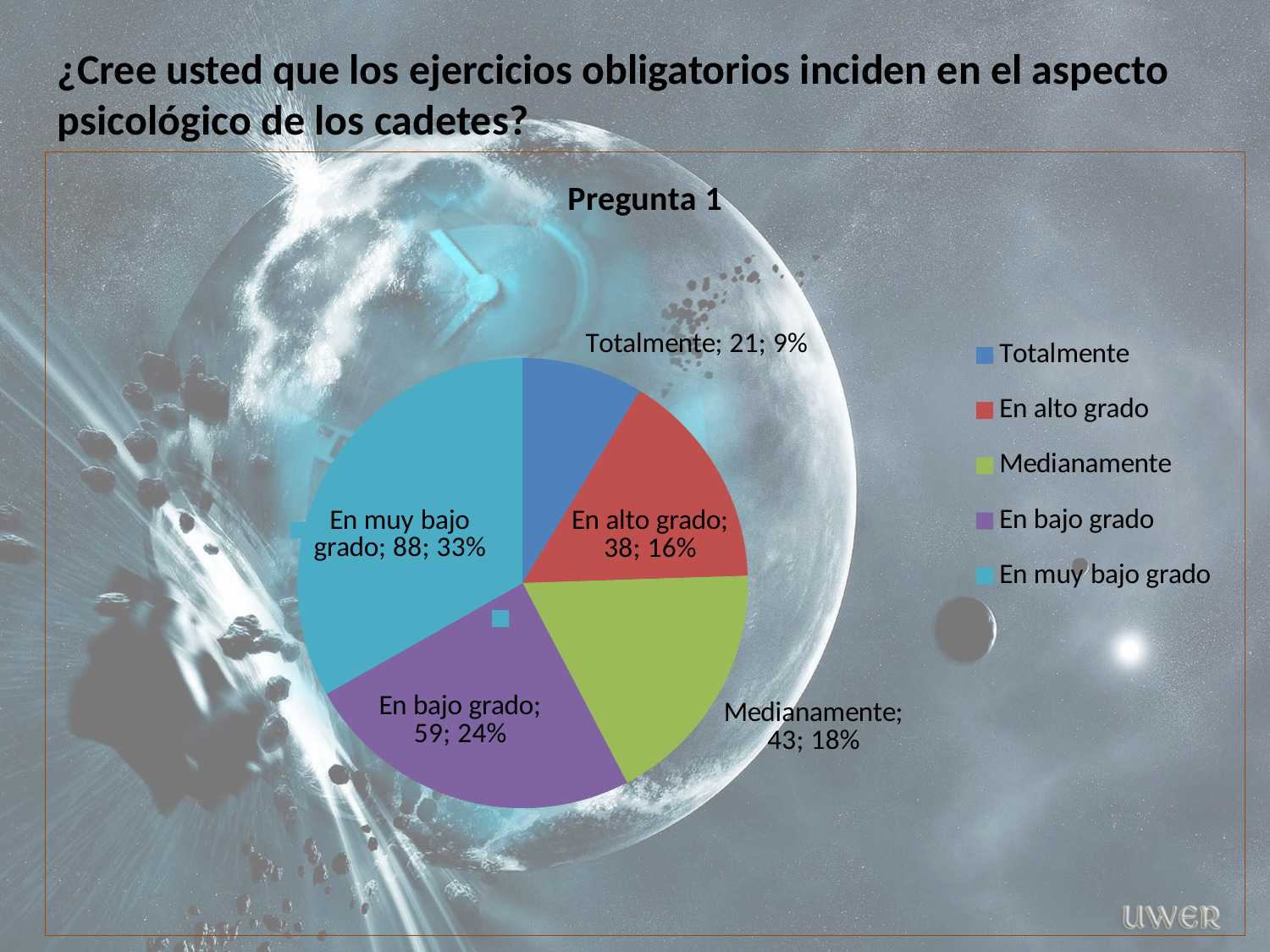
What percentage share does 'Medianamente' have? 18% How many entries does the legend list? 5 Which is larger, the value for 'En alto grado' or the value for 'Medianamente'? Medianamente What is the value for 'En muy bajo grado'? 88 Which category has the smallest slice? Totalmente What kind of chart is shown on the slide? pie chart What percentage share does 'En bajo grado' have? 24% Which category has the largest slice? En muy bajo grado What is the value for 'Totalmente'? 21 What is the difference between the values for 'En muy bajo grado' and 'En bajo grado'? 29 How many slices does the pie chart have? 5 What is the title of the chart? Pregunta 1